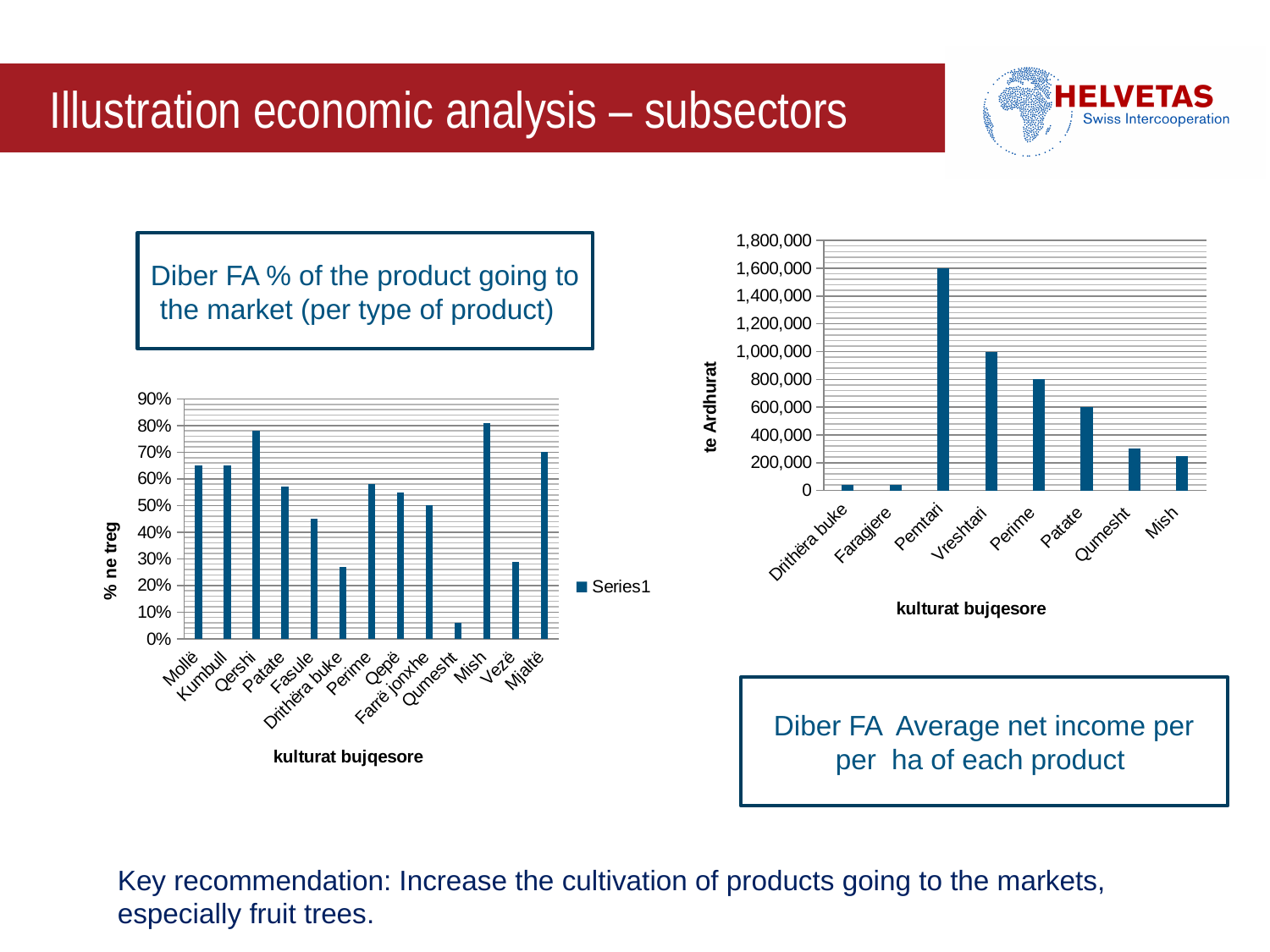
On the right chart (Average net income per ha), how many categories are shown on the x axis? 8 On the left chart (% of the product going to the market), what kind of chart is it? bar chart On the right chart (Average net income per ha), which category has the highest value? Pemtari On the right chart (Average net income per ha), which is larger, the value for Perime or the value for Patate? Perime On the left chart (% of the product going to the market), how many categories are shown on the x axis? 13 On the right chart (Average net income per ha), what is the value for Pemtari? 1,600,000 On the right chart (Average net income per ha), what is the difference between the values for Pemtari and Vreshtari? 600,000 On the right chart (Average net income per ha), is the value for Qumesht greater or less than 400,000? less On the right chart (Average net income per ha), what is the value for Perime? 800,000 On the right chart (Average net income per ha), what is the value for Vreshtari? 1,000,000 On the left chart (% of the product going to the market), which category has the lowest value? Qumesht On the left chart (% of the product going to the market), is the value for Mollë greater or less than 60%? greater